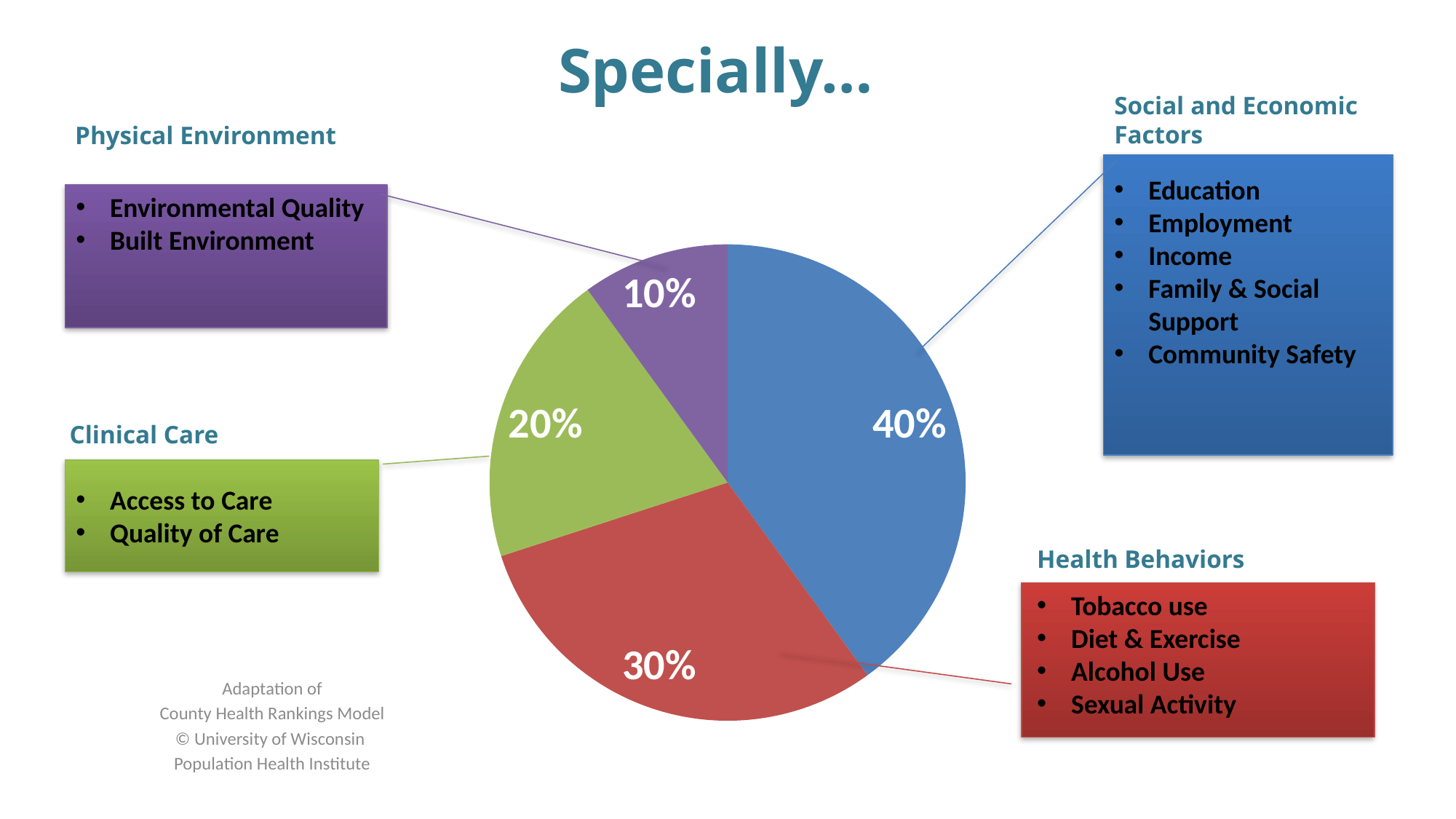
What is the difference between the Social and Economic Factors share and the Clinical Care share? 20% Which category has the largest slice of the pie? Social and Economic Factors What share of the pie is labelled for Health Behaviors? 30% What kind of chart is shown on the slide? pie chart Which category has the smallest slice of the pie? Physical Environment How many slices does the pie chart have? 4 What share of the pie is labelled for Physical Environment? 10% What share of the pie is labelled for Clinical Care? 20% What share of the pie is labelled for Social and Economic Factors? 40% What colour is the Health Behaviors slice of the pie? red What is the combined share of Physical Environment and Clinical Care? 30% Which is larger, the Health Behaviors slice or the Clinical Care slice? Health Behaviors